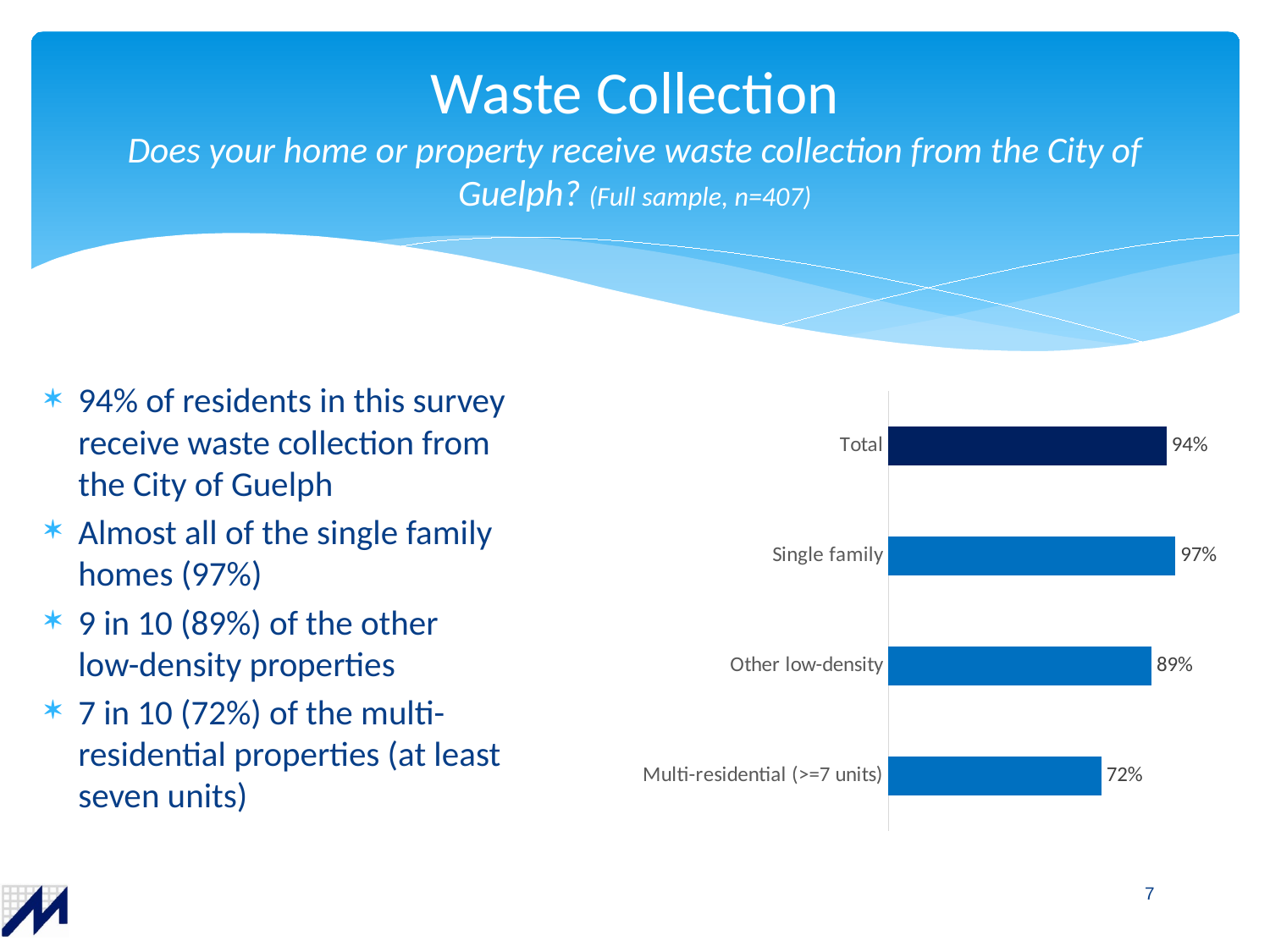
What is the difference between the values for Single family and Multi-residential (>=7 units)? 25% What kind of chart is shown on the slide? Bar chart Which category has the highest value? Single family What is the value for Total? 94% How many categories are shown in the chart? 4 What is the difference between the values for Total and Other low-density? 5% Which is larger, the value for Other low-density or the value for Multi-residential (>=7 units)? Other low-density What is the value for Single family? 97% Which category's bar is drawn in a darker blue than the others? Total What is the value for Other low-density? 89% What is the value for Multi-residential (>=7 units)? 72% Which category has the lowest value? Multi-residential (>=7 units)